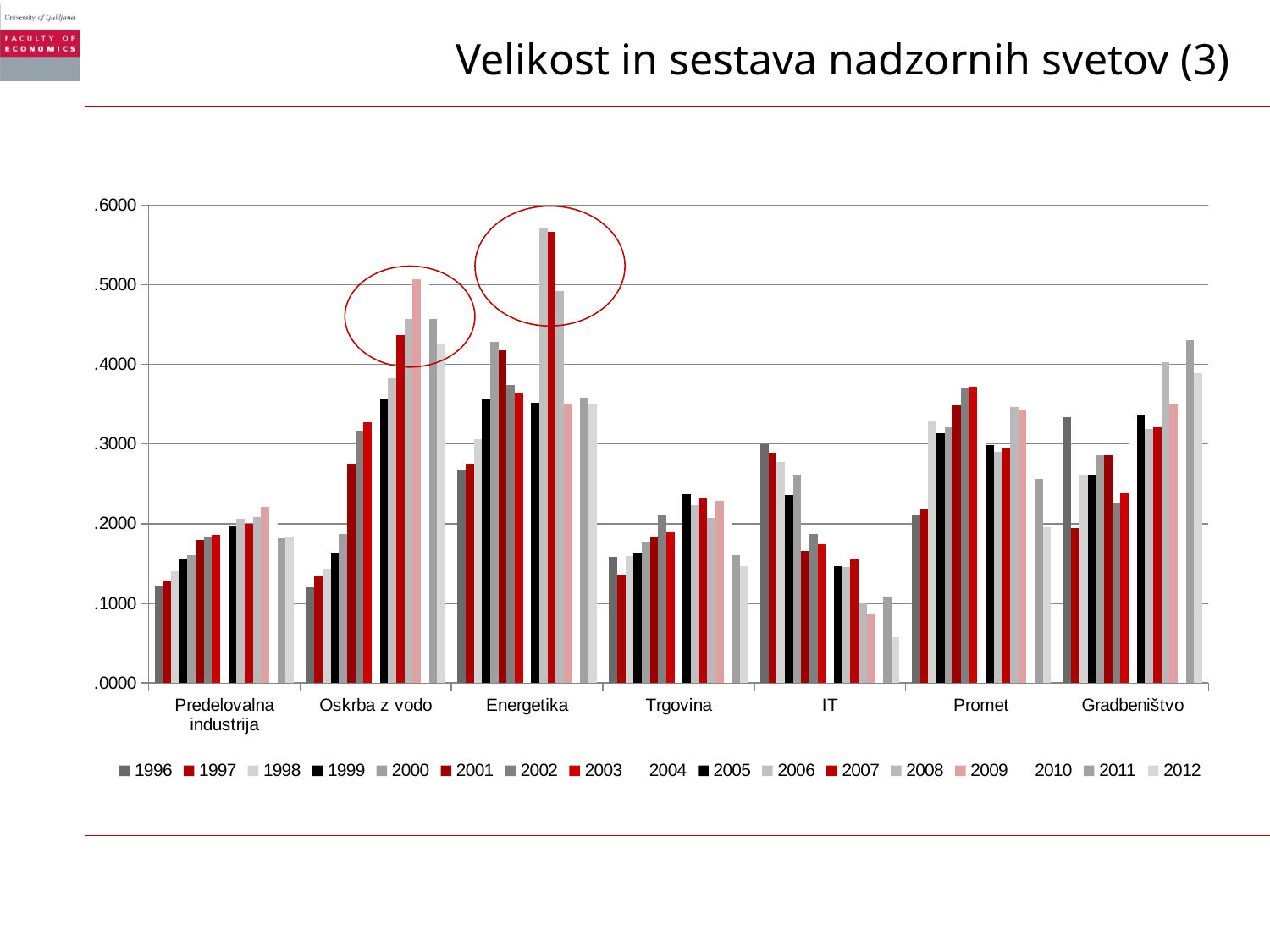
How many series does the chart's legend list? 17 Which category has the taller maximum bar, Energetika or Trgovina? Energetika How many categories are shown along the x axis of the chart? 7 Is the tallest bar in the Energetika category greater or less than .5000? greater What kind of chart is shown on the slide? bar chart What is the title of the slide containing the chart? Velikost in sestava nadzornih svetov (3) Which category contains the tallest bar on the chart? Energetika Is the tallest bar in the Trgovina category greater or less than .3000? less Is the tallest bar in the Predelovalna industrija category greater or less than .3000? less Which two categories on the chart are highlighted with red circles? Oskrba z vodo and Energetika Which category contains the shortest bar on the chart? IT